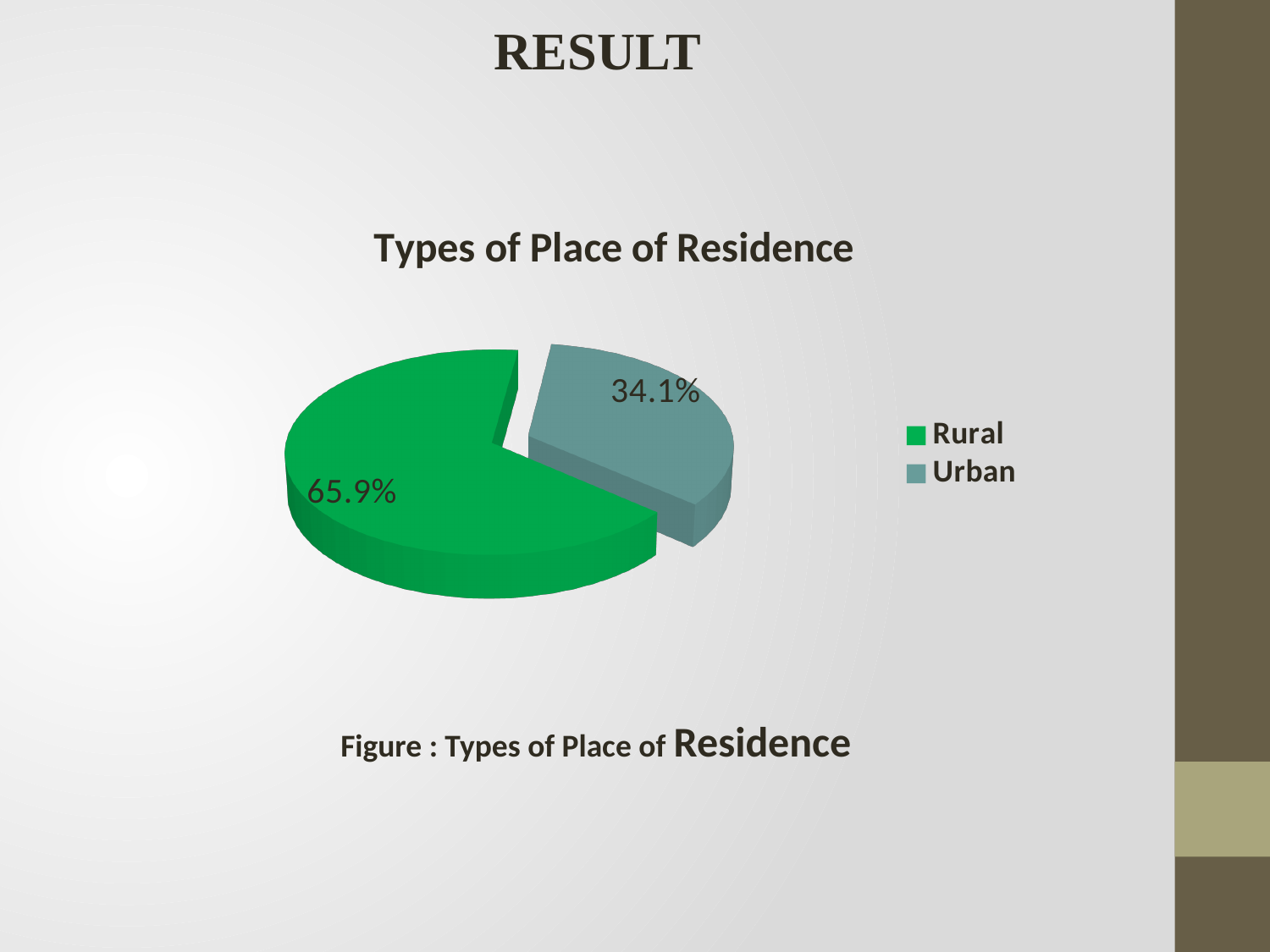
What is the title of the chart? Types of Place of Residence How many entries does the legend list? 2 Which category has the smallest share of the pie? Urban What percentage of the pie is Rural? 65.9% What is the difference in percentage points between the Rural and Urban shares? 31.8 What kind of chart is shown on the slide? Pie chart What percentage of the pie is Urban? 34.1% How many slices does the pie chart have? 2 Which category has the largest share of the pie? Rural What colour is the Rural slice? Green Which is larger, the Rural share or the Urban share? Rural What is the share of the pie for Urban? 34.1%